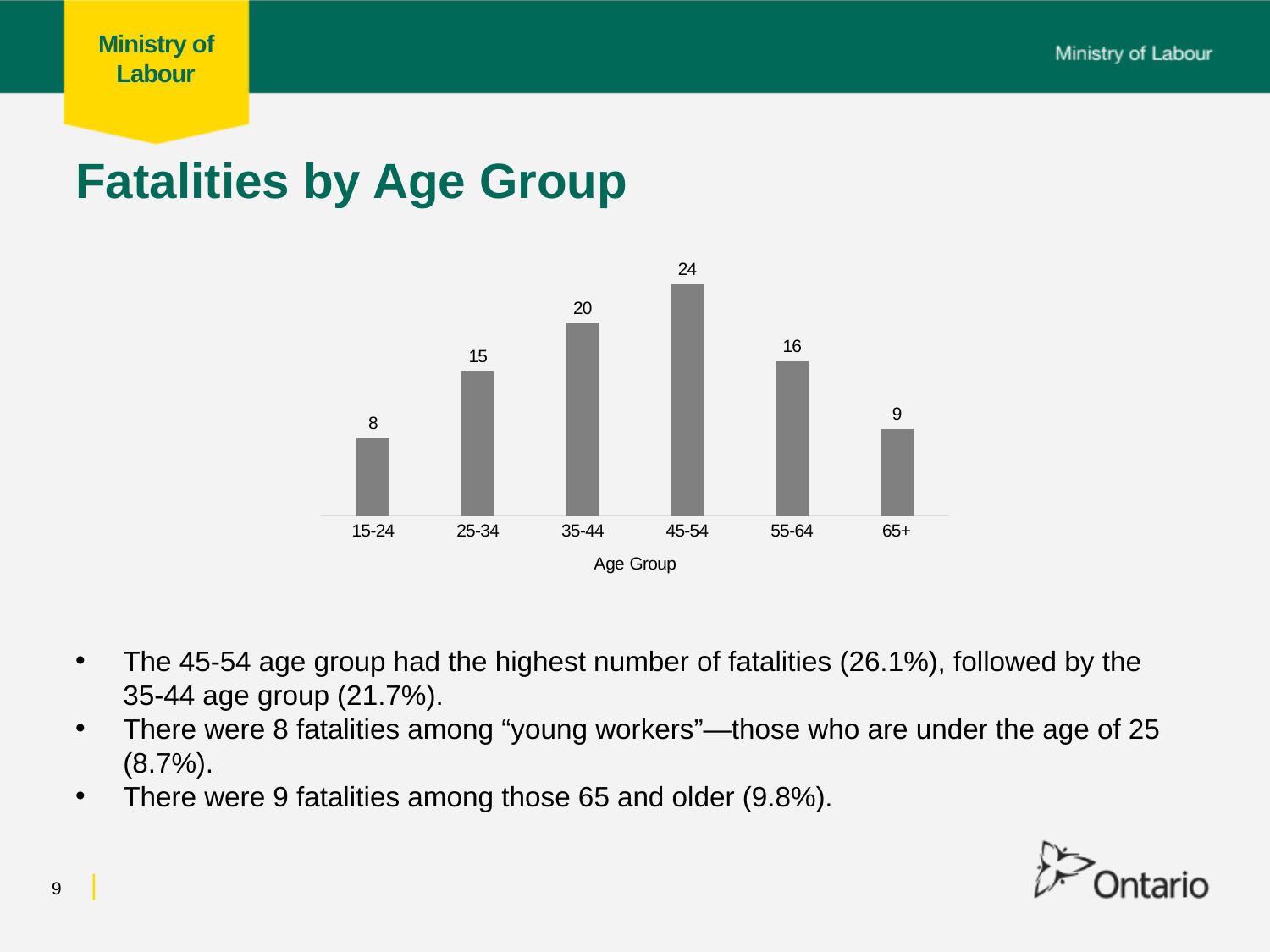
What is the number of fatalities for the 55-64 age group? 16 Which age group has the lowest number of fatalities? 15-24 Which age group has the highest number of fatalities? 45-54 How many age groups are shown in the chart? 6 Which age group has more fatalities, 25-34 or 55-64? 55-64 What is the difference in fatalities between the 45-54 and 35-44 age groups? 4 Do the fatality counts rise or fall from the 45-54 age group to the 65+ age group? Fall What kind of chart is shown on the slide? Bar chart What is the label of the x axis of the chart? Age Group What is the number of fatalities for the 15-24 age group? 8 What is the difference in fatalities between the 25-34 and 65+ age groups? 6 What is the number of fatalities for the 45-54 age group? 24